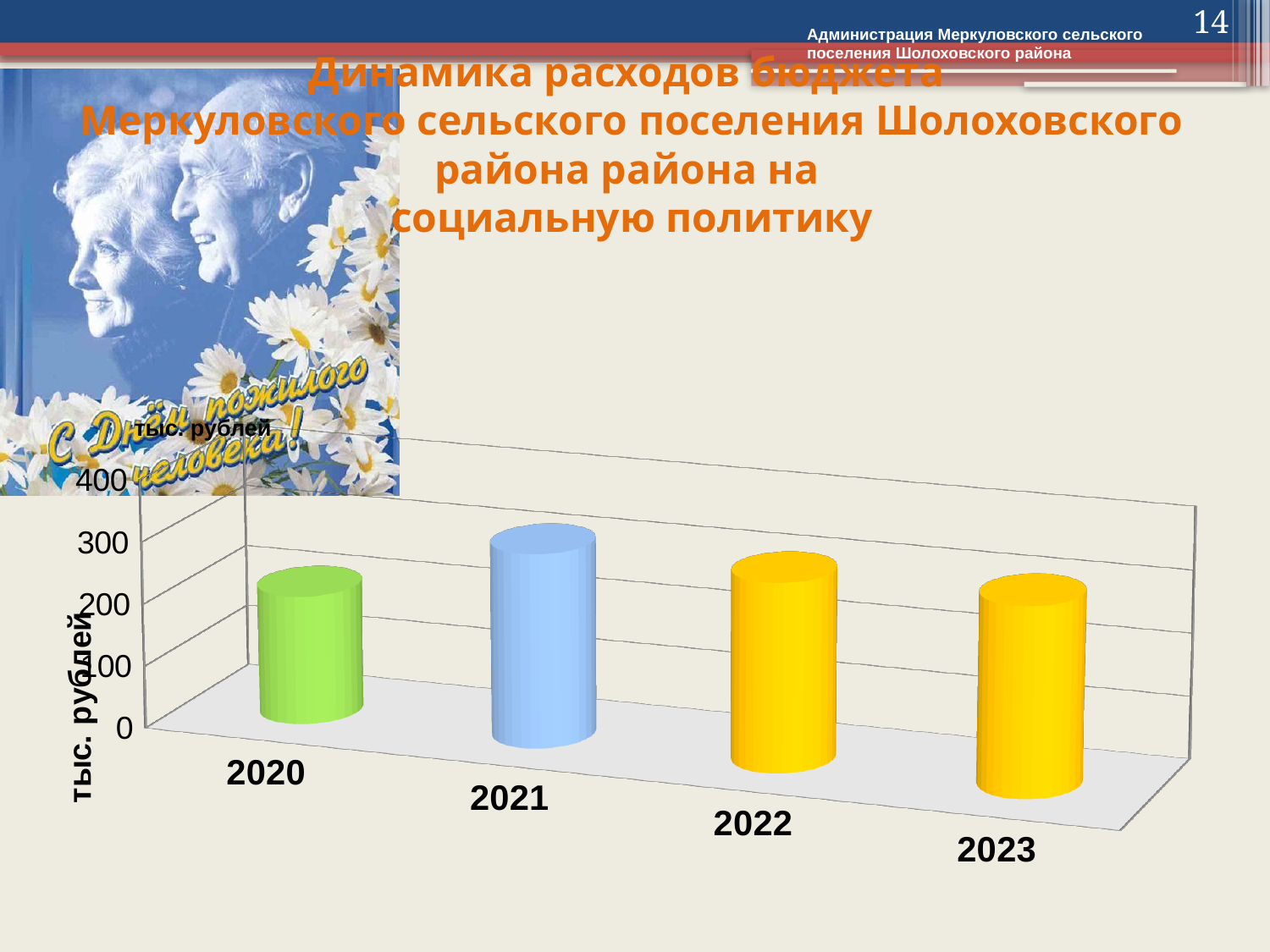
Is the value for 2020 greater or less than 100? greater Is the value for 2023 greater or less than 100? greater How many years are shown on the x axis of the chart? 4 What kind of chart is shown on the slide? Bar chart Is the value for 2021 greater or less than 200? greater What is the highest tick value shown on the vertical axis? 400 Which is larger, the value for 2020 or the value for 2021? 2021 Which year has the lowest value in the chart? 2020 What unit is shown on the vertical axis of the chart? тыс. рублей